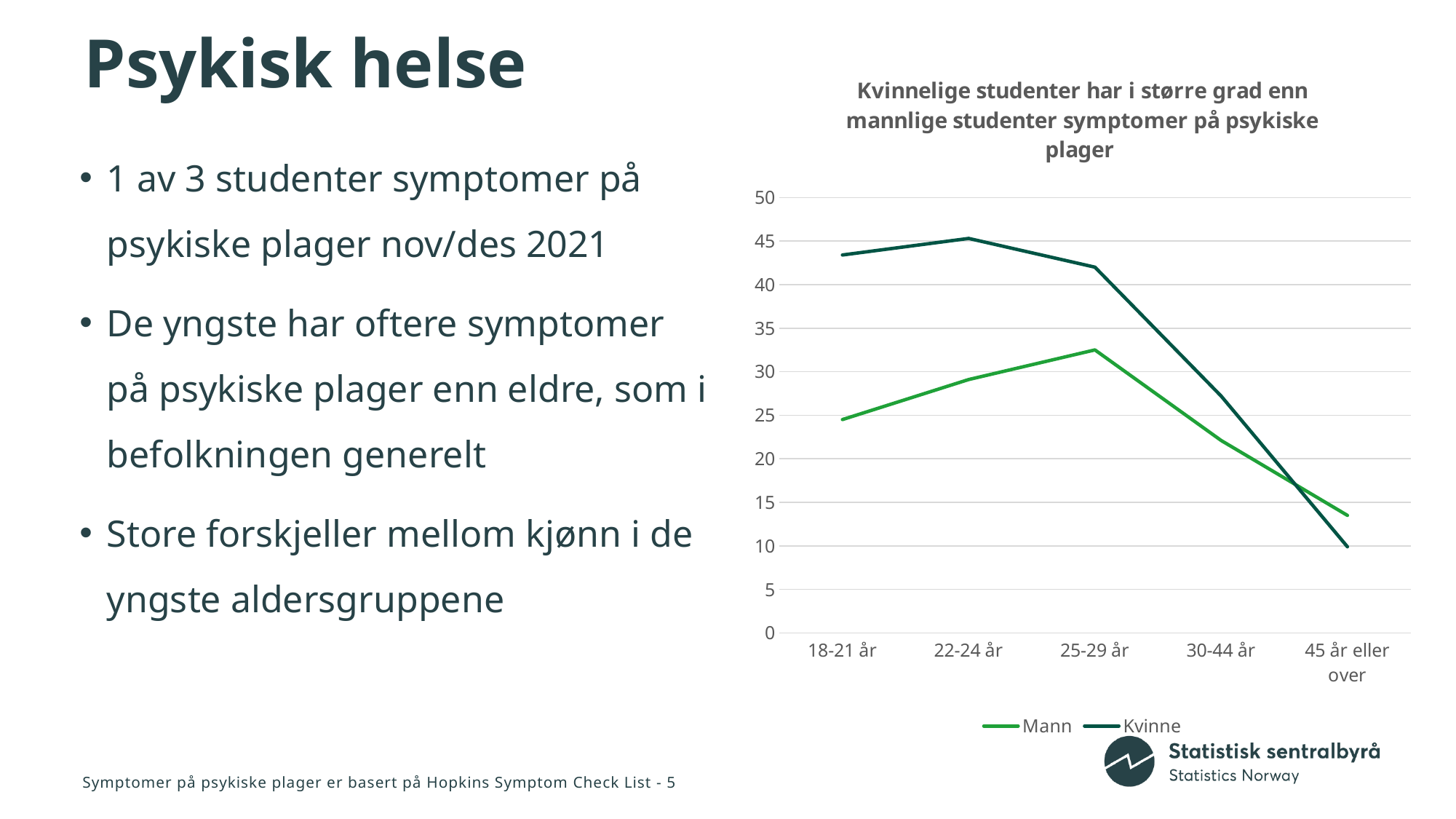
How many age groups are shown on the x axis of the chart? 5 What kind of chart is shown on the slide? line chart Is the Mann value for 45 år eller over greater or less than 15? less What is the title of the chart? Kvinnelige studenter har i større grad enn mannlige studenter symptomer på psykiske plager How many series does the chart's legend list? 2 For which age group is the Kvinne line at its highest? 22-24 år For which age group is the Mann line at its highest? 25-29 år Which series has the higher value for 18-21 år, Mann or Kvinne? Kvinne Does the Kvinne line rise or fall from 25-29 år to 45 år eller over? fall Which series has the higher value for 45 år eller over, Mann or Kvinne? Mann Is the Kvinne value for 18-21 år greater or less than 40? greater For which age group is the Kvinne line at its lowest? 45 år eller over